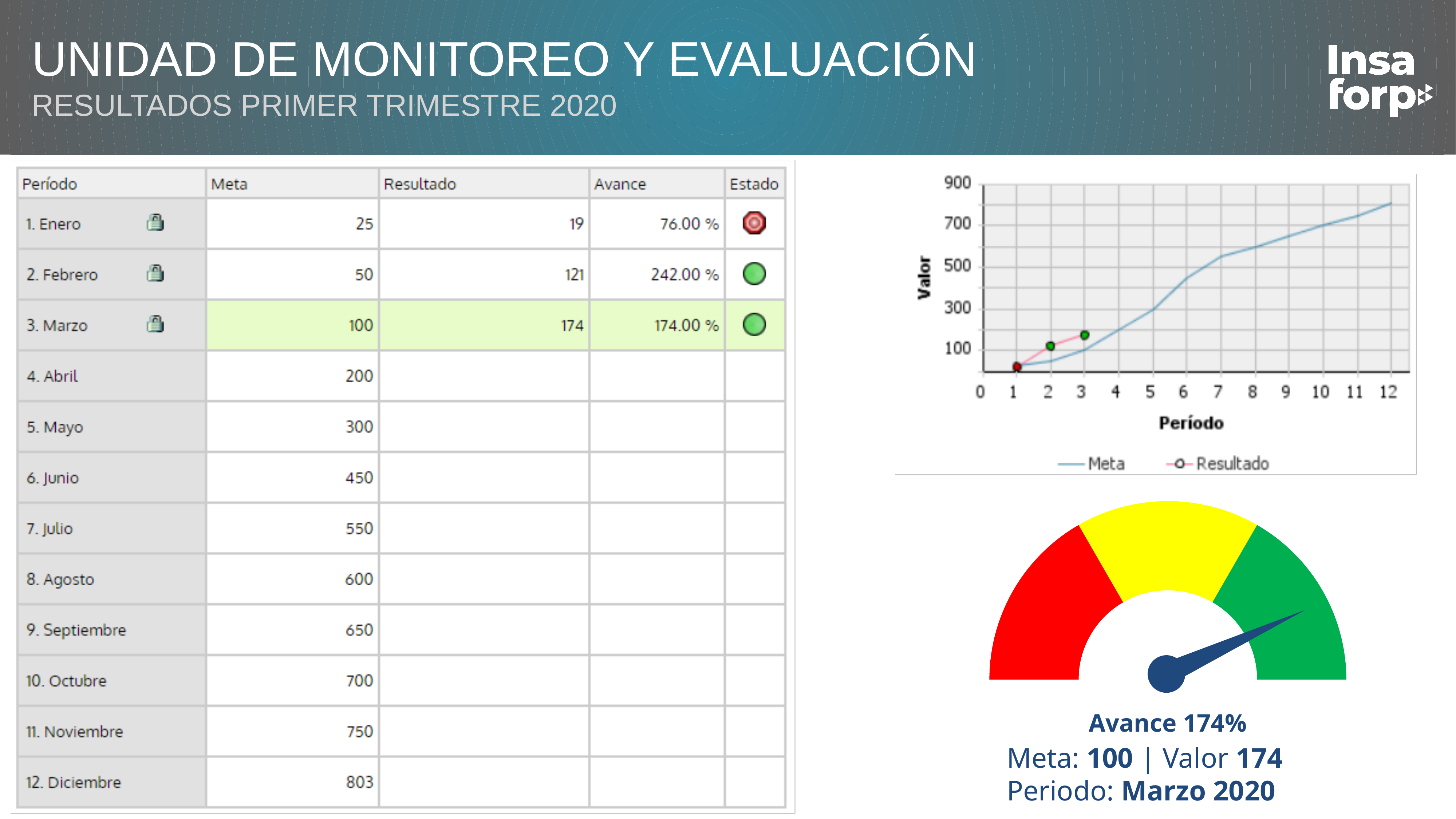
What kind of chart is the chart at the top right with the Período axis? line chart What Meta value is shown below the gauge chart? 100 How many series does the legend of the line chart list? 2 On the gauge chart, what is the difference between the Valor (174) and the Meta (100)? 74 What are the two series named in the legend of the line chart? Meta and Resultado In the line chart, is the Resultado value at Período 1 greater or less than 100? less In the line chart, at which Período does the Meta line reach its highest value? 12 In the line chart, does the Meta line rise or fall as the Período increases from 1 to 12? rises In the line chart, how many data points are plotted for the Resultado series? 3 What Avance percentage is shown below the gauge chart? 174% In the line chart, is the Meta value at Período 12 greater or less than 700? greater In the line chart, at Período 3, which is larger: the Meta value or the Resultado value? Resultado